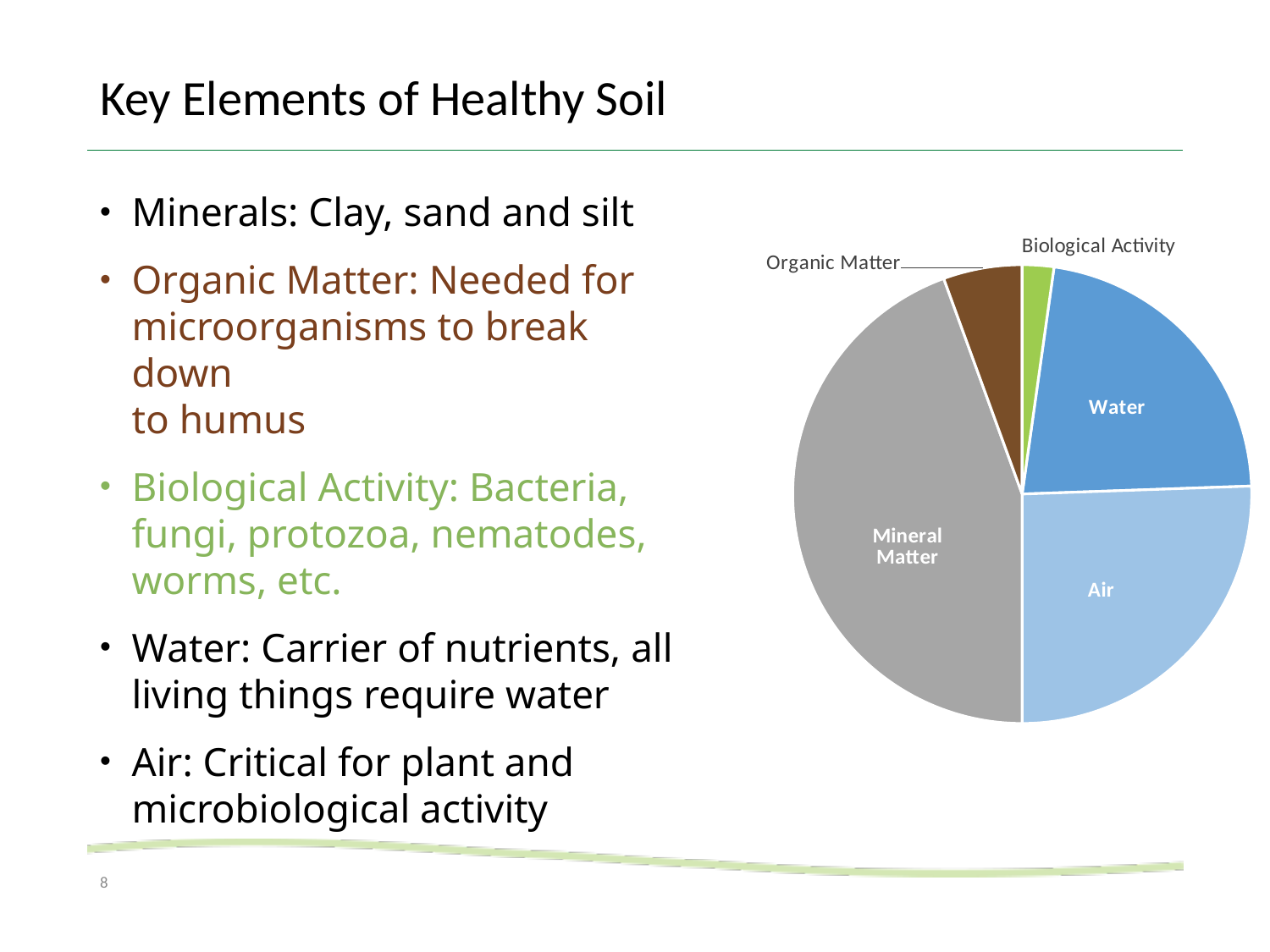
Which slice is larger in the pie chart, Mineral Matter or Air? Mineral Matter Which slice of the pie chart is coloured green? Biological Activity Which slice is larger in the pie chart, Organic Matter or Biological Activity? Organic Matter Which slice of the pie chart is the largest? Mineral Matter Which slice is larger in the pie chart, Water or Organic Matter? Water Which slice of the pie chart is the smallest? Biological Activity How many slices does the pie chart have? 5 What kind of chart is shown on the slide? pie chart What colour is the Mineral Matter slice in the pie chart? grey